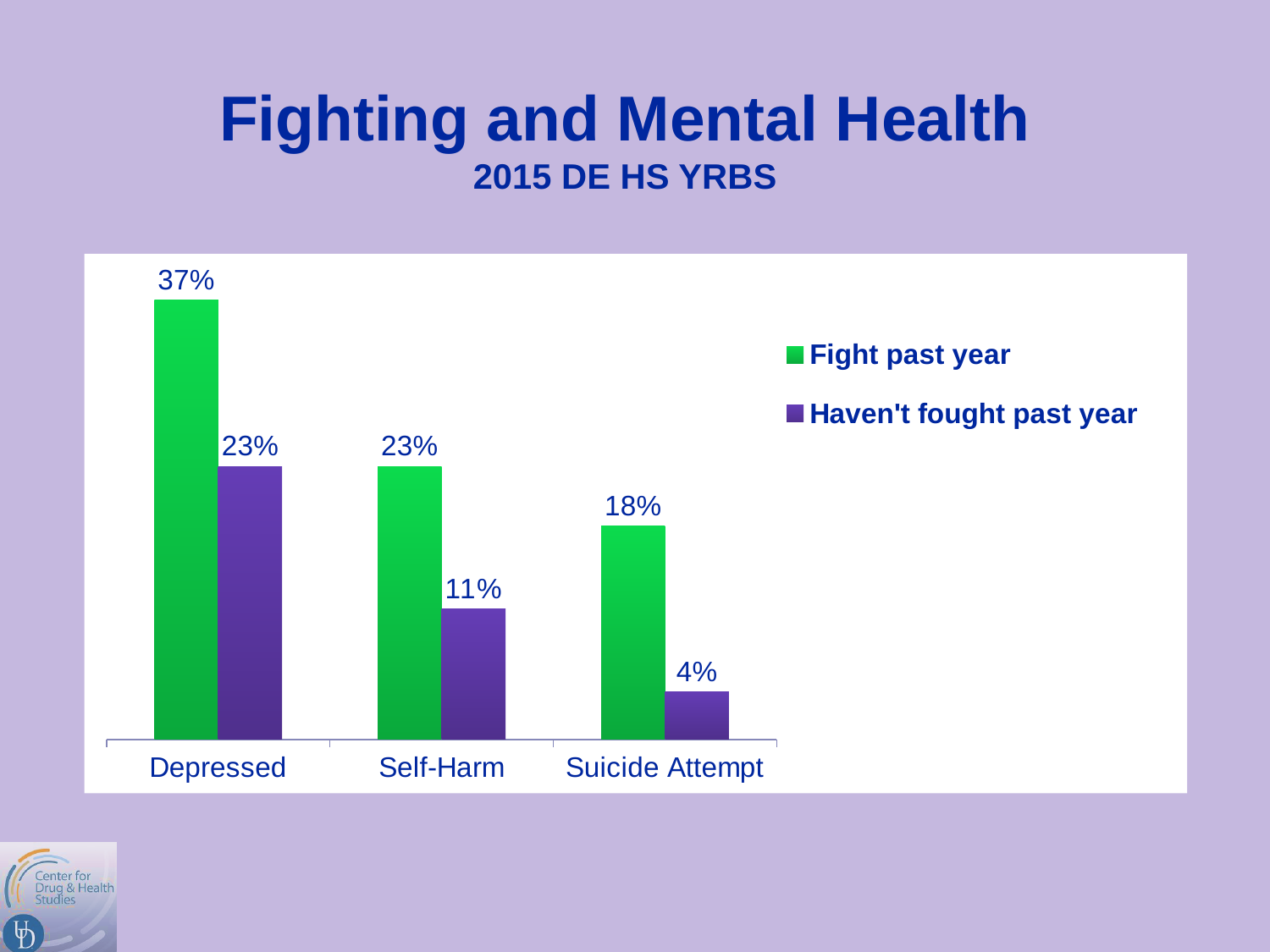
Which series is shown in green? Fight past year Which is larger: the Fight past year value for Self-Harm or the Haven't fought past year value for Self-Harm? Fight past year What kind of chart is shown on the slide? Bar chart Which category has the lowest value in the Haven't fought past year series? Suicide Attempt What is the value for Depressed in the Fight past year series? 37% How many categories are shown on the x axis? 3 What is the value for Self-Harm in the Haven't fought past year series? 11% How many series does the legend list? 2 What is the difference between the Fight past year and Haven't fought past year values for Suicide Attempt? 14% What is the difference between the Fight past year and Haven't fought past year values for Depressed? 14% What is the value for Suicide Attempt in the Haven't fought past year series? 4% Which category has the highest value in the Fight past year series? Depressed